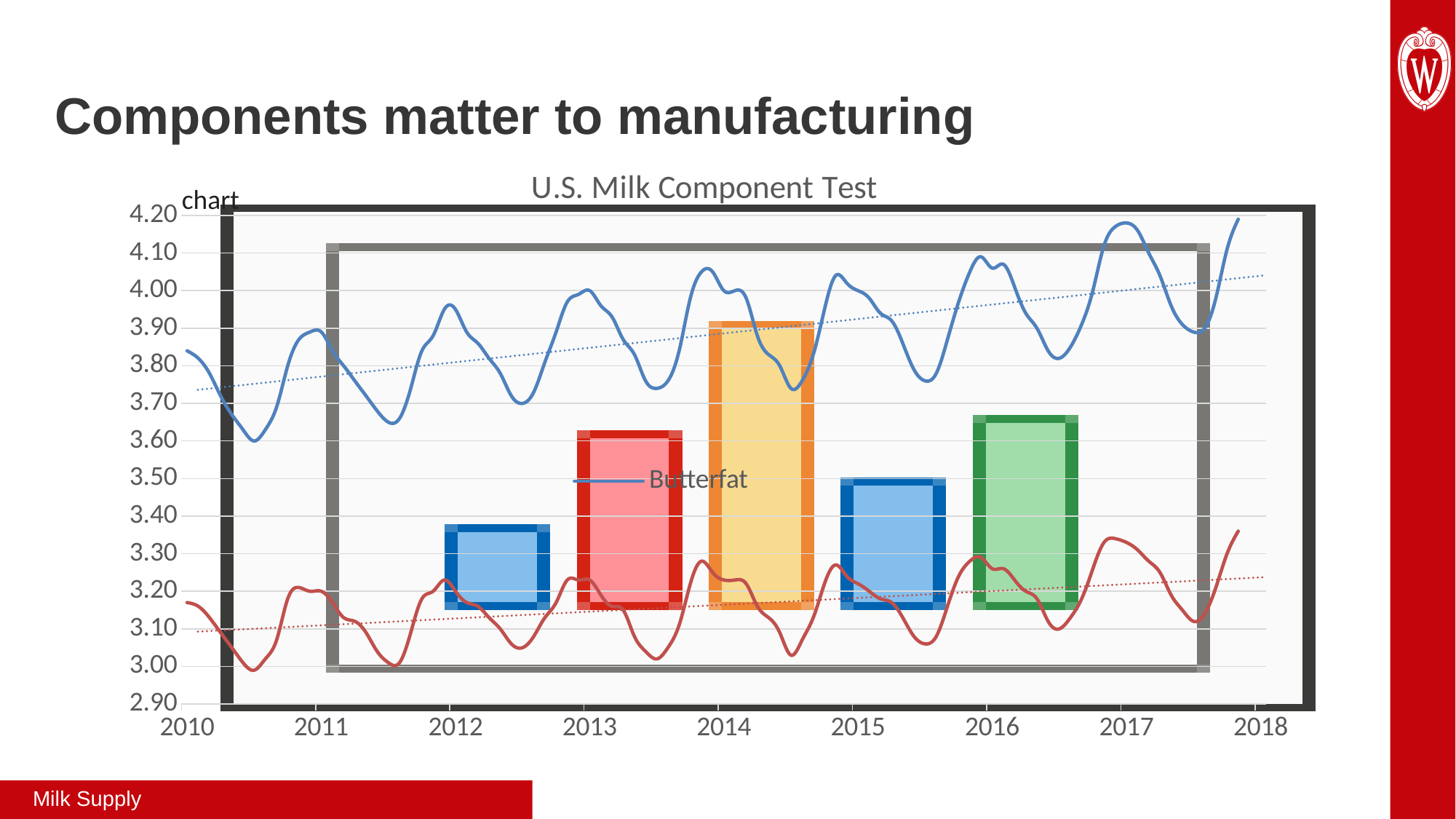
Which line has higher values throughout the chart, the blue Butterfat line or the red line? the blue Butterfat line How many series does the chart's legend list? 1 How many year labels are shown on the x axis? 9 Is the Butterfat value at the start of 2012 greater or less than 3.80? greater What is the title of the chart? U.S. Milk Component Test Is the value of the red line at the start of 2018 greater or less than 3.30? greater Which series is named in the chart's legend? Butterfat Does the Butterfat line generally rise or fall from 2010 to 2018? rise Is the value of the red line at the start of 2010 greater or less than 3.30? less What kind of chart is shown on the slide? line chart What is the highest value shown on the y axis? 4.20